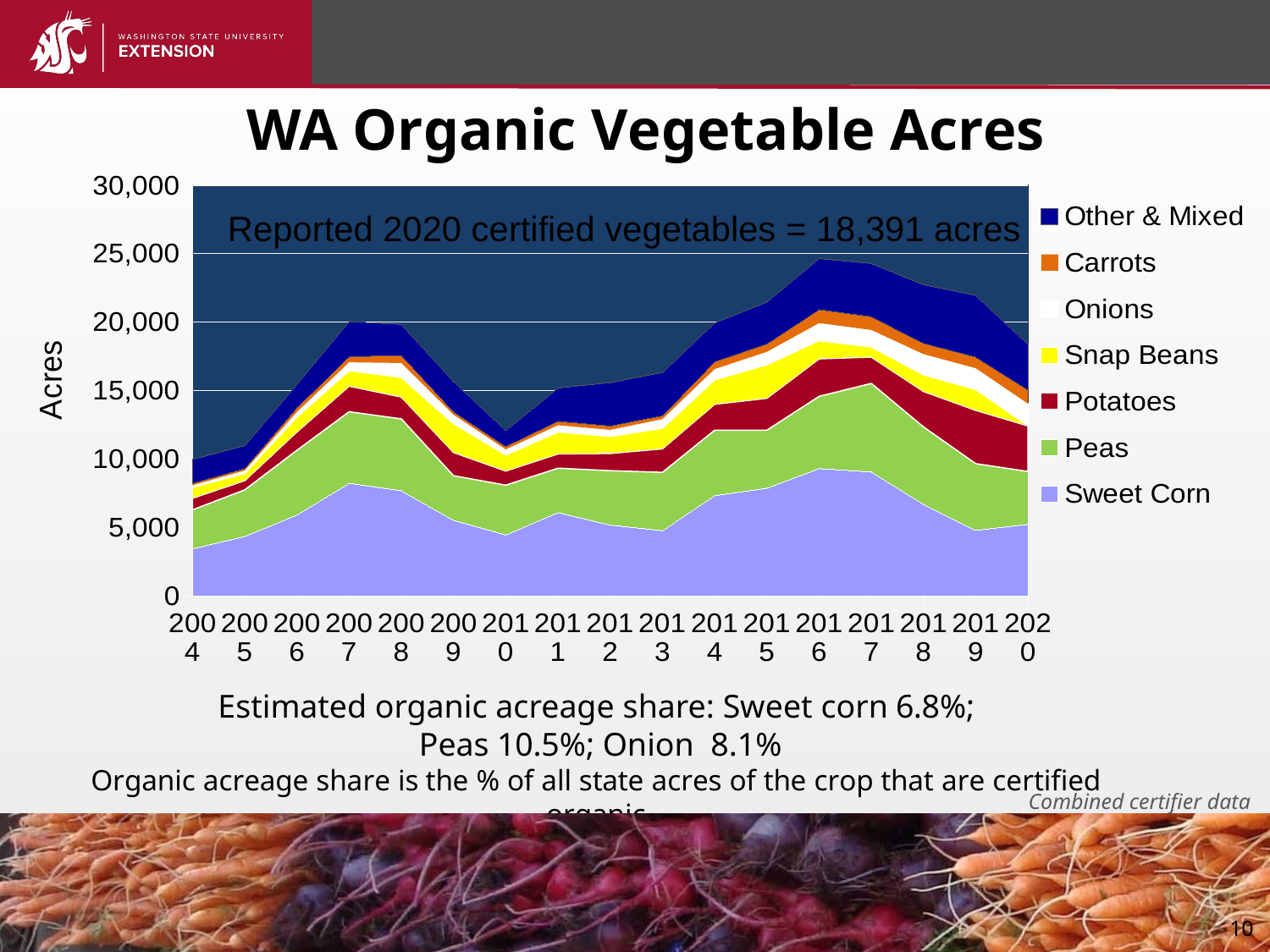
Is the total acreage in 2010 greater or less than 15,000? less What is the reported total of certified vegetable acres for 2020? 18,391 acres Is the Sweet Corn acreage in 2004 greater or less than 5,000? less How many years are shown along the x axis? 17 Does the total acreage rise or fall from 2016 to 2020? Fall How many series does the legend list? 7 What is the title of the chart? WA Organic Vegetable Acres In which year is the total organic vegetable acreage highest? 2016 What kind of chart is shown on the slide? Stacked area chart In which year is the total organic vegetable acreage lowest? 2004 Is the total acreage in 2016 greater or less than 20,000? greater Which series is plotted at the bottom of the stack? Sweet Corn